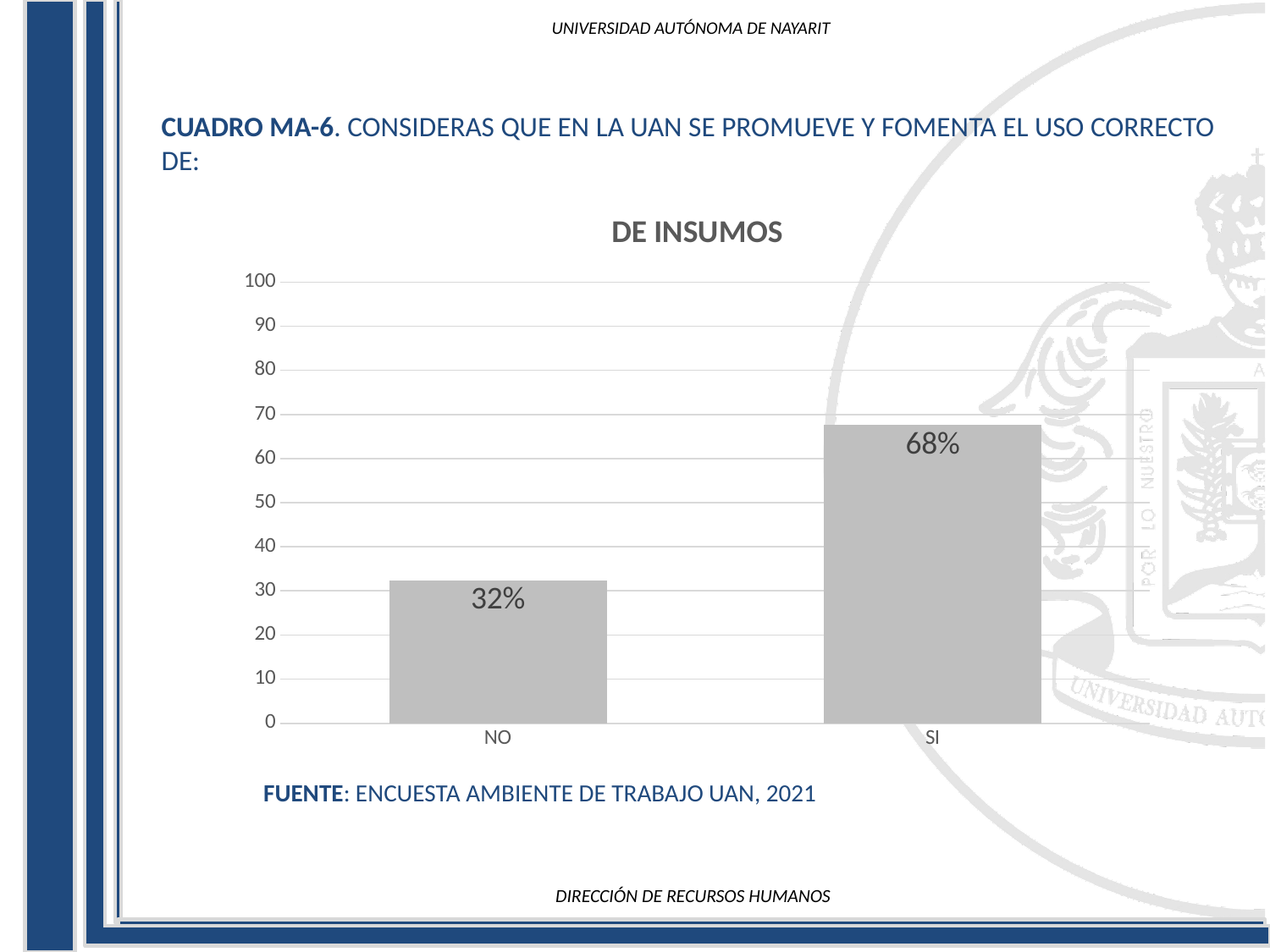
What is the difference between the values for SI and NO? 36% Which is larger, the value for NO or the value for SI? SI What is the highest value shown on the y axis? 100 What is the value for SI? 68% What kind of chart is shown? bar chart How many categories are shown on the x axis? 2 What is the title of the chart? DE INSUMOS What is the value for NO? 32% Is the value for SI greater or less than 60? greater Which category has the highest value? SI Which category has the lowest value? NO Is the value for NO greater or less than 40? less